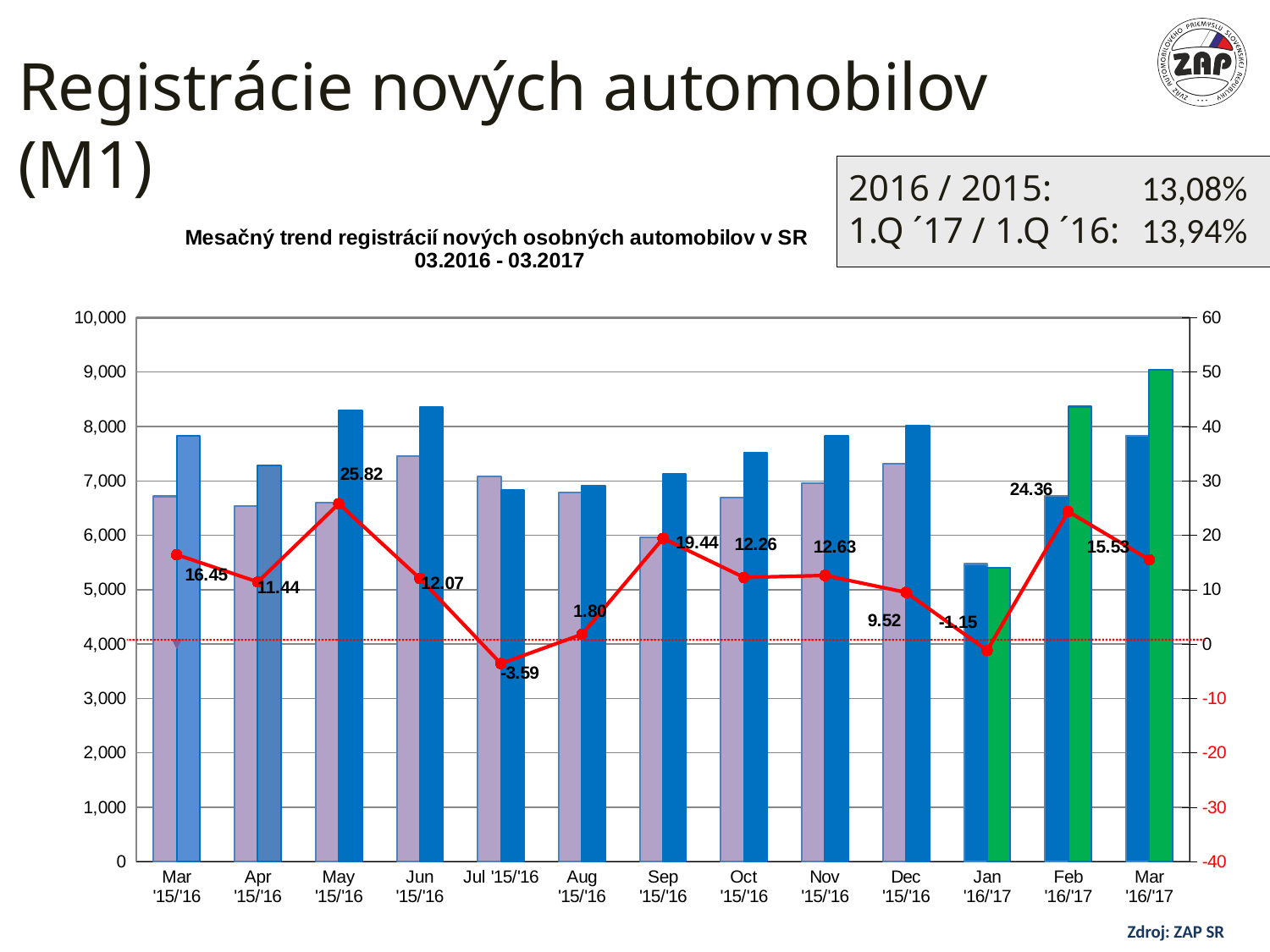
Is the value of the second (right) bar for May '15/'16 greater or less than 8,000? greater Which has a higher line value, Feb '16/'17 or Sep '15/'16? Feb '16/'17 What is the percentage change value shown on the line for Jan '16/'17? -1.15 What is the difference between the line values for May '15/'16 and Jul '15/'16? 29.41 Which month has the highest value on the red line? May '15/'16 What is the percentage change value shown on the line for May '15/'16? 25.82 What kind of chart is shown on the slide? A combined bar chart and line chart Which month has the lowest value on the red line? Jul '15/'16 What is the percentage change value shown on the line for Jul '15/'16? -3.59 What is the difference between the line values for Feb '16/'17 and Mar '16/'17? 8.83 How many month categories are shown on the x axis? 13 Is the value of the second (right) bar for Jan '16/'17 greater or less than 6,000? less